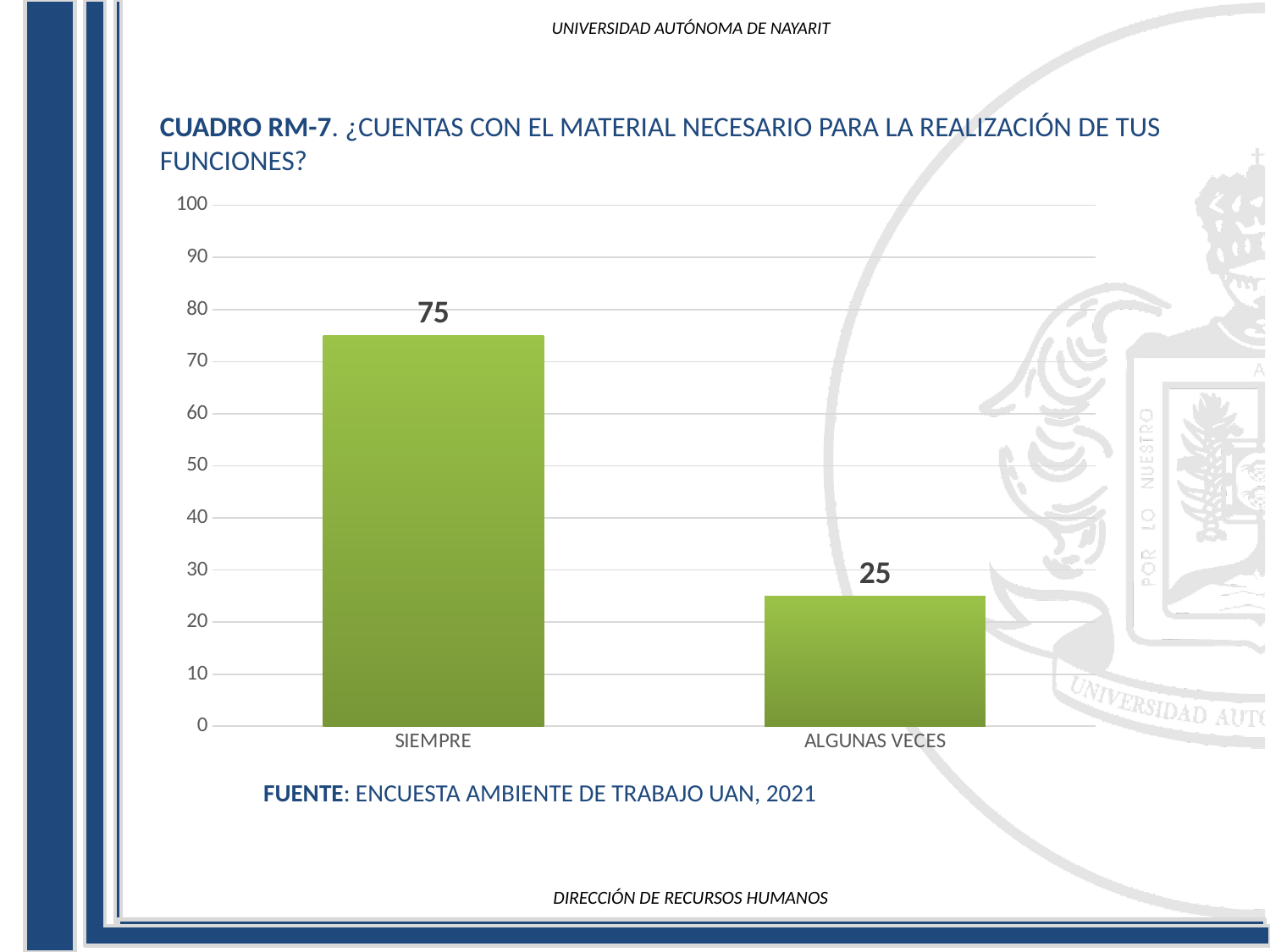
How many categories are shown on the x axis? 2 Which is larger, the value for SIEMPRE or the value for ALGUNAS VECES? SIEMPRE Is the value for ALGUNAS VECES greater or less than 30? less What is the value for SIEMPRE? 75 What is the value for ALGUNAS VECES? 25 What is the difference between the values for SIEMPRE and ALGUNAS VECES? 50 What kind of chart is shown on the slide? bar chart Is the value for SIEMPRE greater or less than 50? greater Which category has the lowest value? ALGUNAS VECES What is the total of the two bar values? 100 Which category has the highest value? SIEMPRE What source is cited below the chart? ENCUESTA AMBIENTE DE TRABAJO UAN, 2021